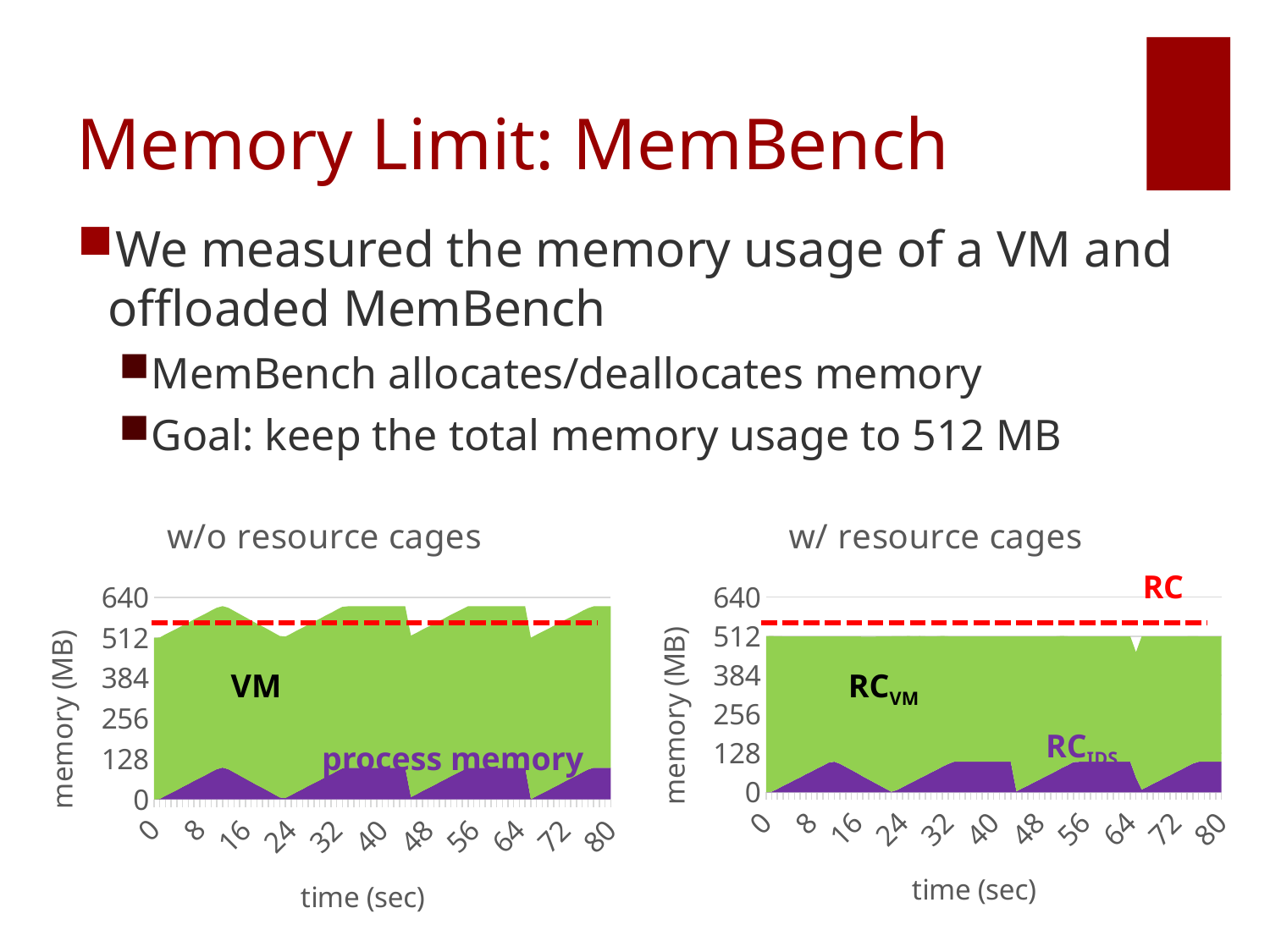
In the 'w/ resource cages' chart, is the total memory usage at time 40 greater or less than 640? less What is the x-axis label of the 'w/o resource cages' chart? time (sec) In the 'w/o resource cages' chart, is the total memory usage at time 16 greater or less than 512? greater In the 'w/o resource cages' chart, is the total memory usage at time 40 greater or less than 512? greater What is the y-axis label of the 'w/ resource cages' chart? memory (MB) What kind of chart is the 'w/o resource cages' chart? stacked area chart In the 'w/o resource cages' chart, which series is larger at time 16, VM or process memory? VM How many data series are plotted in the 'w/ resource cages' chart? 2